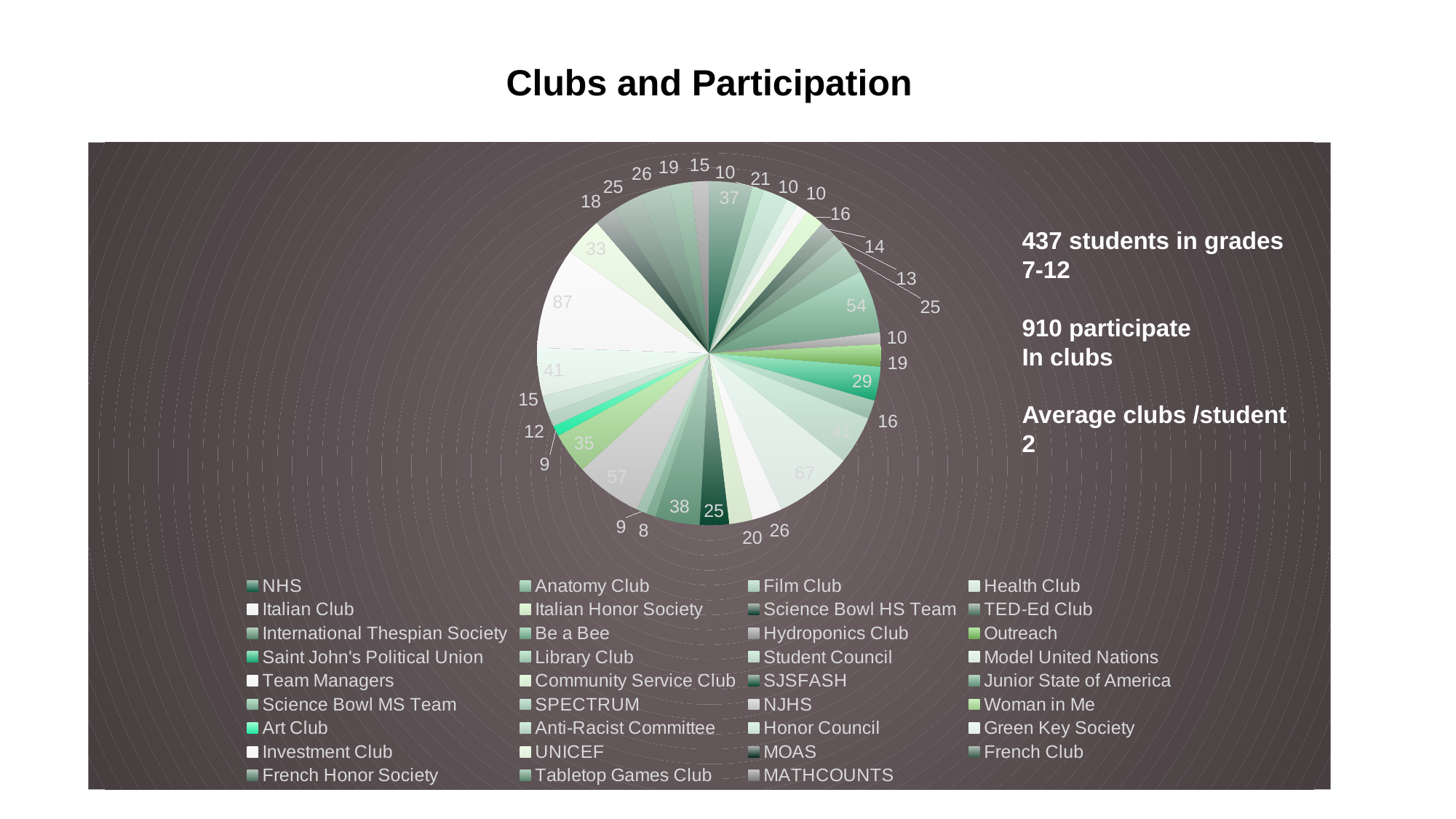
What is the value of the largest slice in the pie chart? 87 What is the value of the smallest slice in the pie chart? 8 How many clubs are listed in the chart's legend? 35 What is the value of the NHS slice (the dark green slice at the top of the pie)? 37 What kind of chart is shown on the slide? pie chart According to the slide, what is the total number of club participations represented by the pie? 910 What is the difference between the two largest slices (87 and 67)? 20 What is the title of the chart? Clubs and Participation Which is larger, the slice labelled 57 or the slice labelled 54? 57 How many slices in the pie chart have a value greater than 50? 4 How many slices in the pie chart are labelled 10? 4 According to the text beside the chart, what is the average number of clubs per student? 2